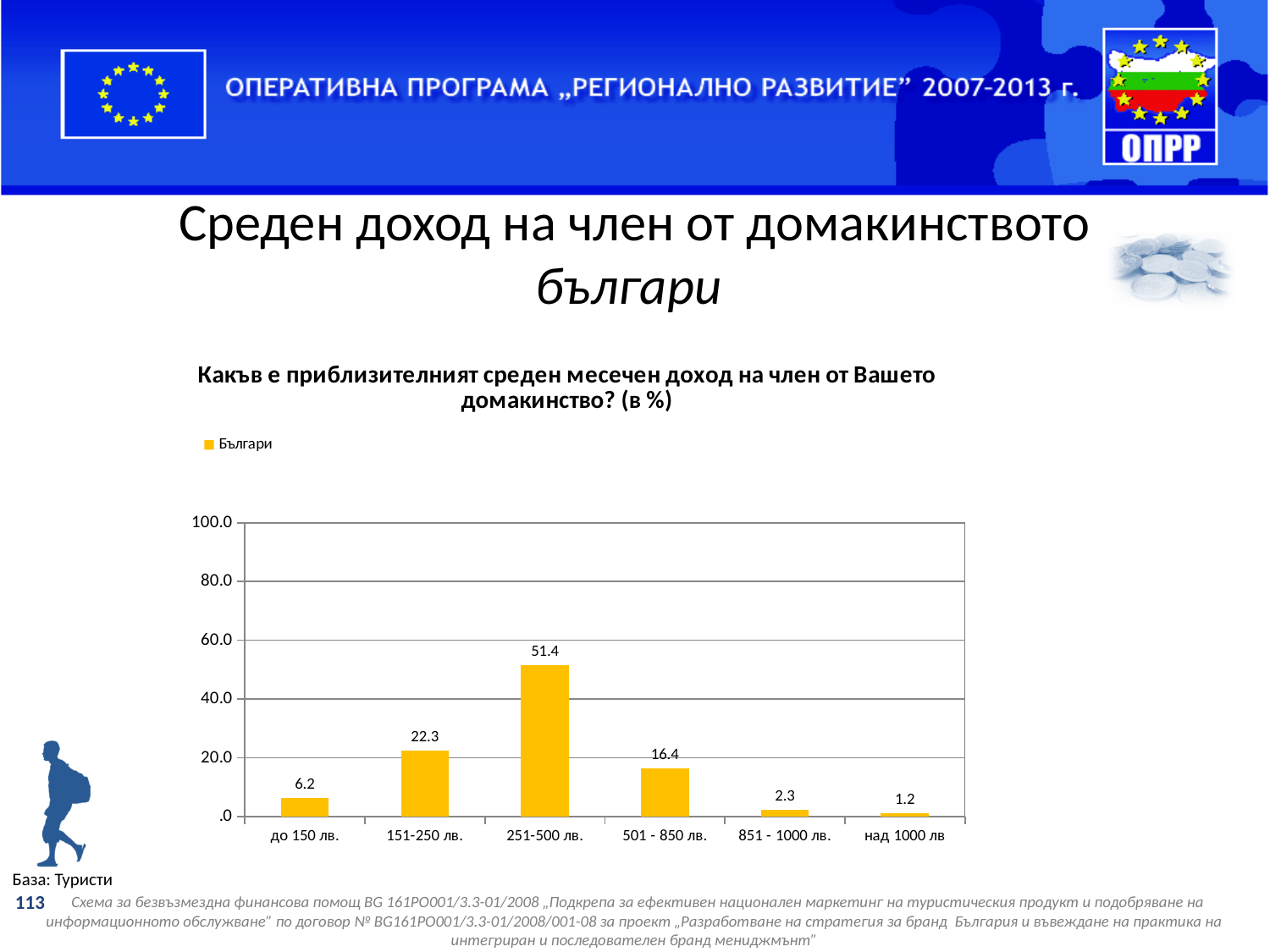
What is the difference between the values for "151-250 лв." and "501 - 850 лв."? 5.9 What is the value for the "251-500 лв." category? 51.4 Which category has the lowest value? над 1000 лв Which category has the highest value? 251-500 лв. Which is larger, the value for "151-250 лв." or the value for "501 - 850 лв."? 151-250 лв. What kind of chart is shown on the slide? bar chart How many categories are shown on the x axis? 6 What is the value for the "851 - 1000 лв." category? 2.3 Is the value for "251-500 лв." greater or less than 40.0? greater What is the value for the "до 150 лв." category? 6.2 What series name is shown in the legend? Българи How many series does the legend list? 1